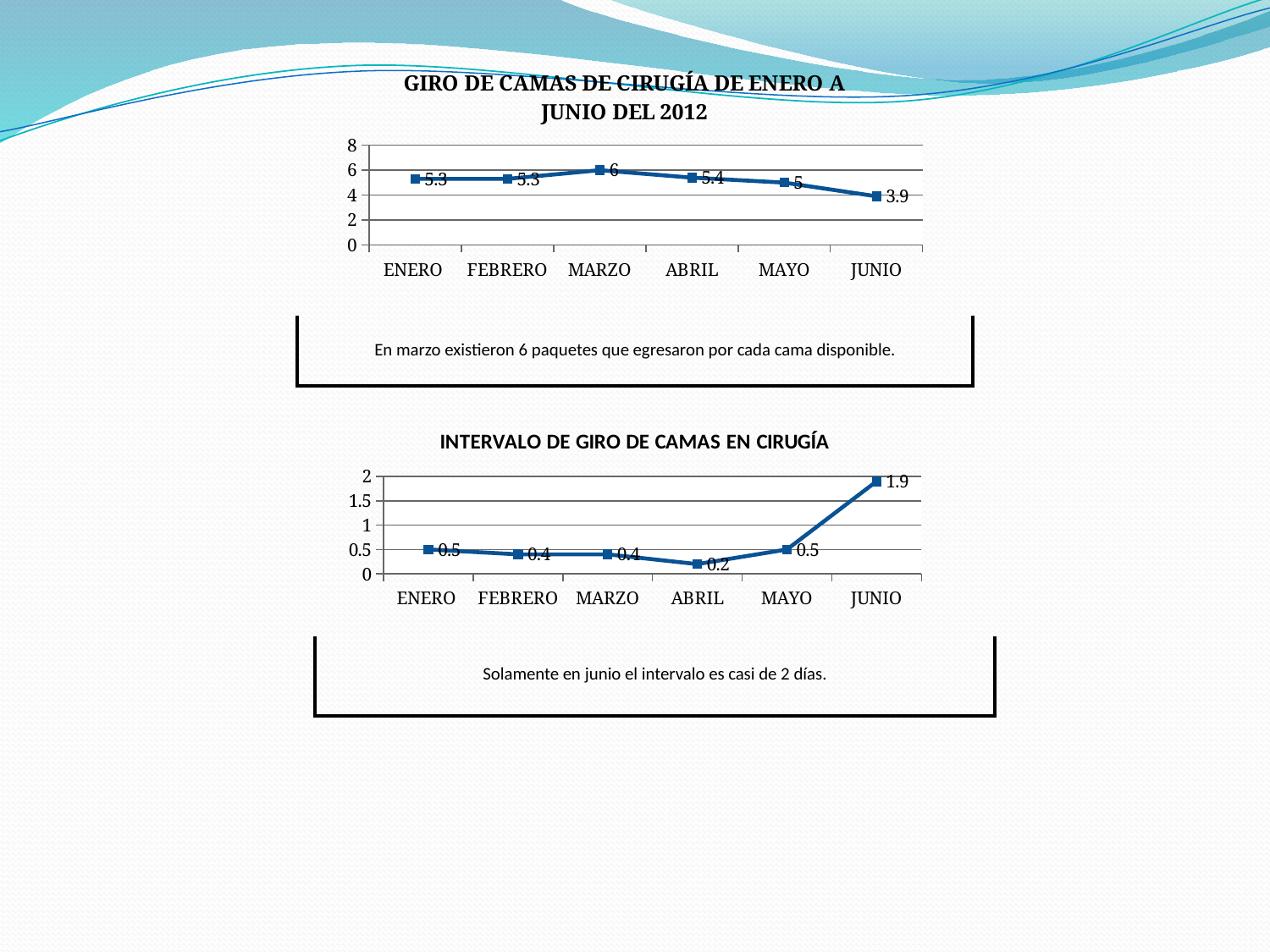
In the chart 'INTERVALO DE GIRO DE CAMAS EN CIRUGÍA', what is the value for ABRIL? 0.2 In the chart 'GIRO DE CAMAS DE CIRUGÍA DE ENERO A JUNIO DEL 2012', which month has the highest value? MARZO What kind of chart is 'INTERVALO DE GIRO DE CAMAS EN CIRUGÍA'? Line chart In the chart 'INTERVALO DE GIRO DE CAMAS EN CIRUGÍA', what is the difference between the values for JUNIO and MAYO? 1.4 In the chart 'GIRO DE CAMAS DE CIRUGÍA DE ENERO A JUNIO DEL 2012', what is the value for MARZO? 6 In the chart 'INTERVALO DE GIRO DE CAMAS EN CIRUGÍA', what is the value for JUNIO? 1.9 In the chart 'INTERVALO DE GIRO DE CAMAS EN CIRUGÍA', which is larger, the value for MAYO or the value for ABRIL? MAYO In the chart 'GIRO DE CAMAS DE CIRUGÍA DE ENERO A JUNIO DEL 2012', what is the difference between the values for MARZO and JUNIO? 2.1 In the chart 'GIRO DE CAMAS DE CIRUGÍA DE ENERO A JUNIO DEL 2012', how many months are plotted? 6 In the chart 'GIRO DE CAMAS DE CIRUGÍA DE ENERO A JUNIO DEL 2012', what is the value for JUNIO? 3.9 In the chart 'GIRO DE CAMAS DE CIRUGÍA DE ENERO A JUNIO DEL 2012', which month has the lowest value? JUNIO In the chart 'INTERVALO DE GIRO DE CAMAS EN CIRUGÍA', which month has the highest value? JUNIO